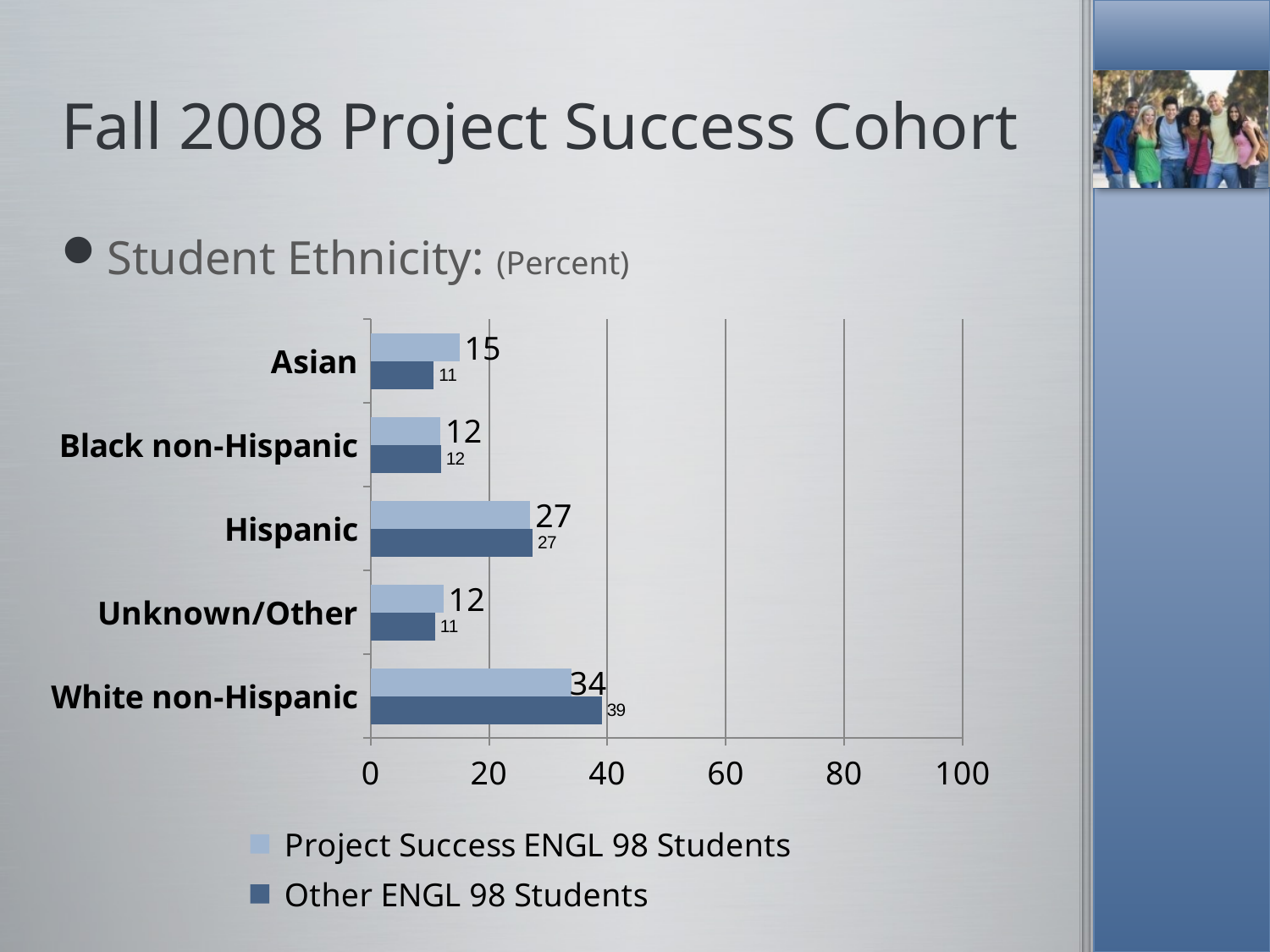
What is the value for Other ENGL 98 Students in the Unknown/Other category? 11 How many series does the legend list? 2 How many ethnicity categories are shown in the chart? 5 Is the value for Hispanic Project Success ENGL 98 Students greater or less than 40? less What kind of chart is shown on the slide? bar chart What is the value for Project Success ENGL 98 Students in the Hispanic category? 27 What is the difference between the Other ENGL 98 Students value and the Project Success ENGL 98 Students value for White non-Hispanic? 5 What is the value for Project Success ENGL 98 Students in the Asian category? 15 What is the value for Other ENGL 98 Students in the White non-Hispanic category? 39 For the Asian category, which series has the larger value: Project Success ENGL 98 Students or Other ENGL 98 Students? Project Success ENGL 98 Students Which ethnicity category has the highest value for Project Success ENGL 98 Students? White non-Hispanic